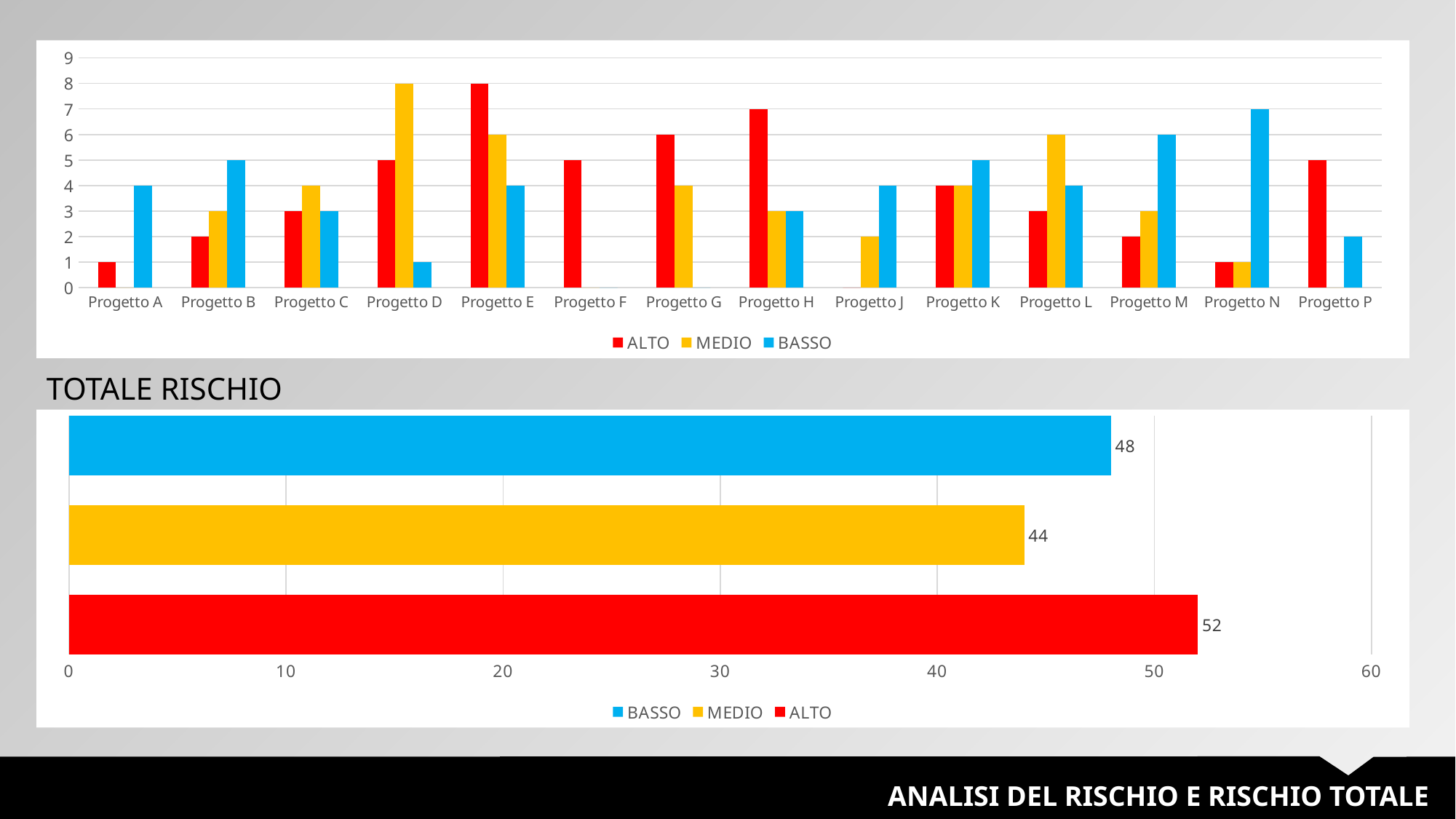
In the top chart, which project has the highest MEDIO value? Progetto D In the bottom chart titled TOTALE RISCHIO, what is the difference between the ALTO and BASSO values? 4 In the bottom chart titled TOTALE RISCHIO, what is the value for MEDIO? 44 In the bottom chart titled TOTALE RISCHIO, is the value for BASSO greater or less than 50? less What kind of chart is the bottom chart titled TOTALE RISCHIO? Bar chart In the top chart, what is the ALTO value for Progetto E? 8 In the bottom chart titled TOTALE RISCHIO, which category has the highest value? ALTO In the top chart, how many series does the legend list? 3 In the bottom chart titled TOTALE RISCHIO, which category has the lowest value? MEDIO In the top chart, what is the BASSO value for Progetto N? 7 In the top chart, how many projects are shown on the x axis? 14 In the bottom chart titled TOTALE RISCHIO, what is the value for ALTO? 52